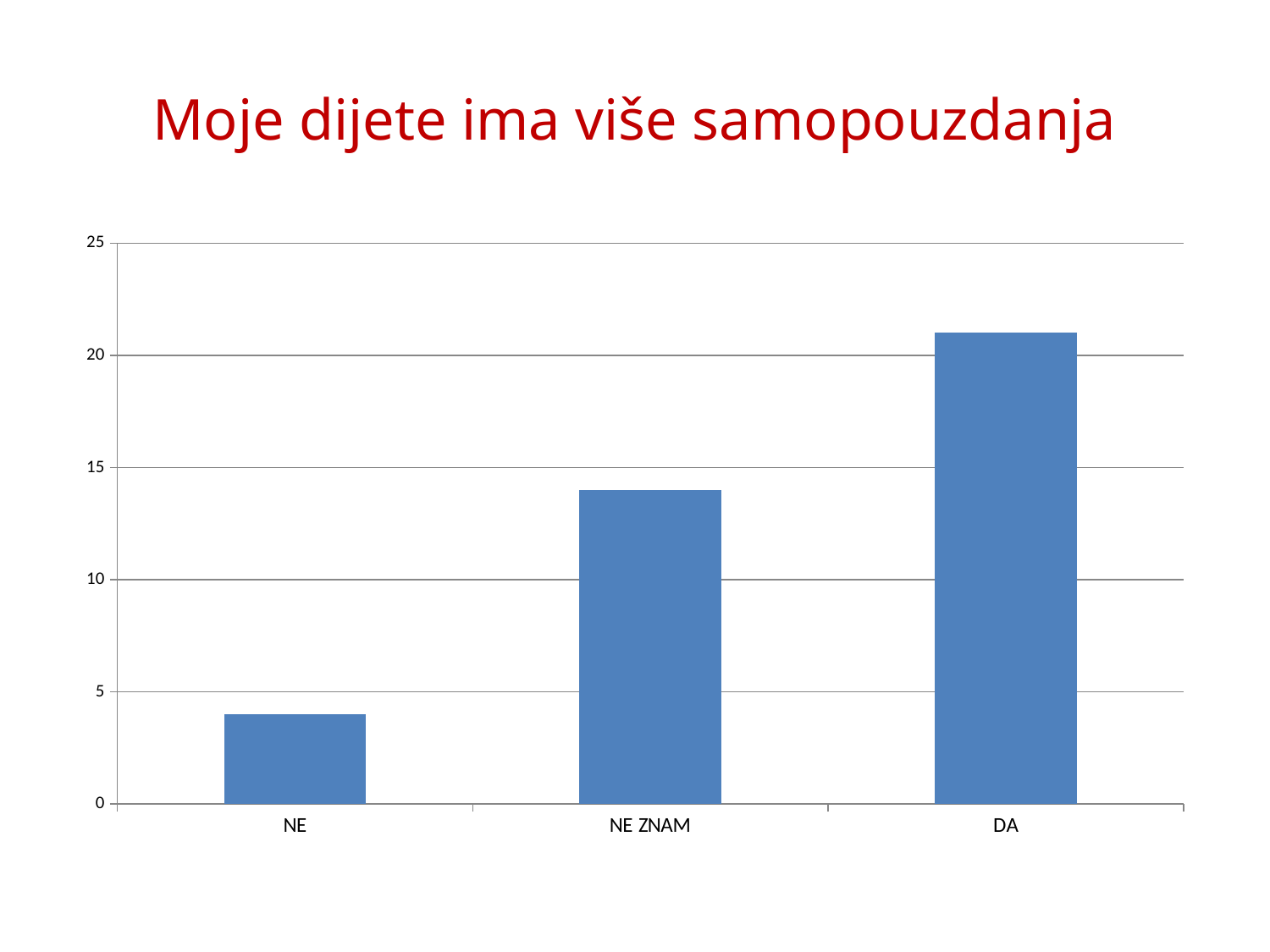
What is the highest value shown on the y axis? 25 Do the bar values rise or fall from left to right along the x axis? rise Which category has the highest bar? DA What is the title of the slide? Moje dijete ima više samopouzdanja Is the value for NE ZNAM greater or less than 10? greater Is the value for NE ZNAM greater or less than 15? less Is the value for NE greater or less than 5? less Which category has the lowest bar? NE How many categories are shown on the x axis of the chart? 3 What kind of chart is shown on the slide? bar chart Which is larger, the value for NE ZNAM or the value for DA? DA